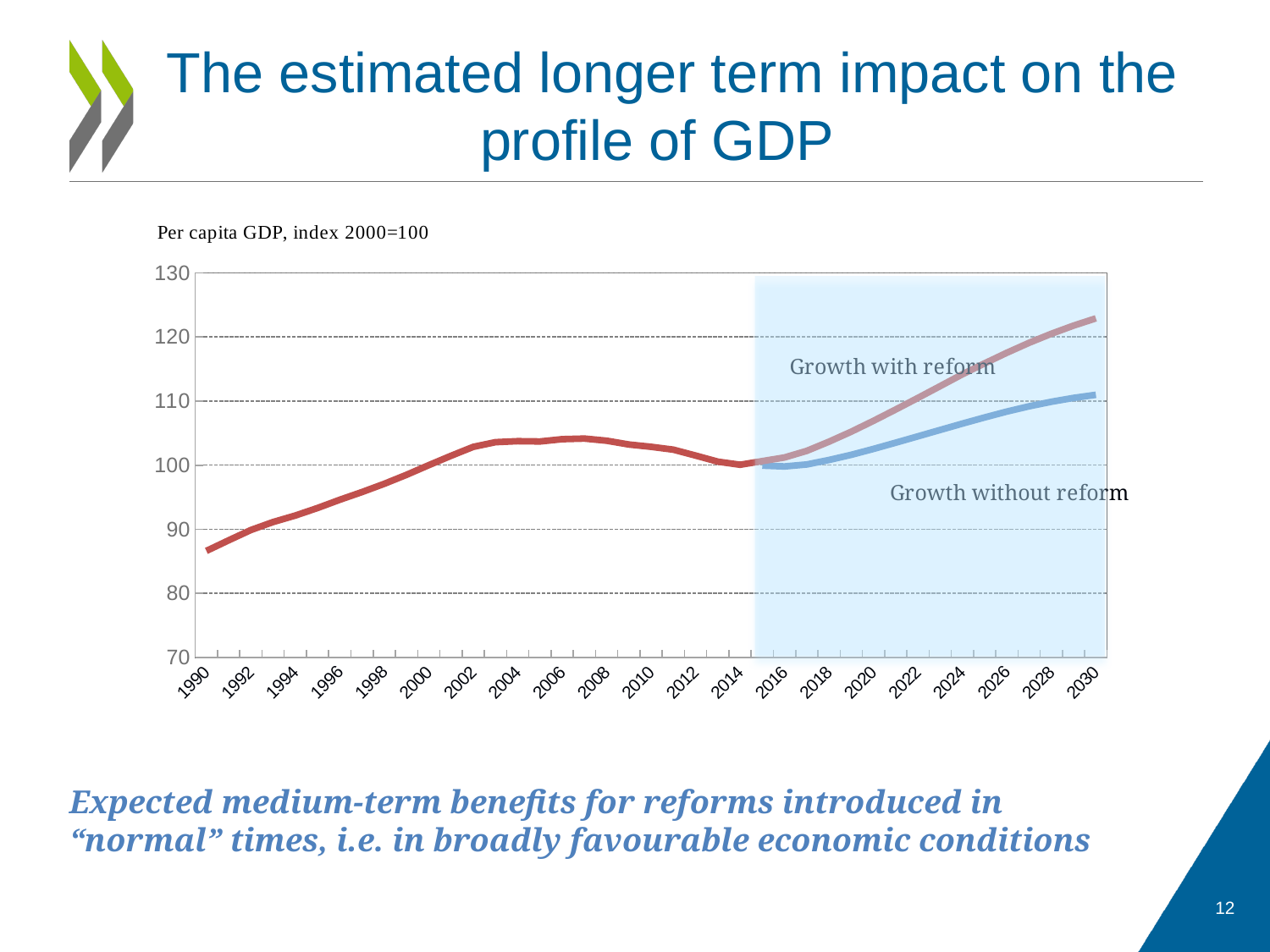
What is the title of the chart (the text above the plot area)? Per capita GDP, index 2000=100 In 2030, which line is higher: 'Growth with reform' or 'Growth without reform'? Growth with reform Does the per capita GDP index rise or fall between 1990 and 2002? rise What are the two labelled projection lines in the shaded area called? Growth with reform; Growth without reform Is the per capita GDP index value in 1990 greater or less than 90? less In which year does the chart show the lowest per capita GDP index value? 1990 What is the per capita GDP index value in 2000? 100 What kind of chart is shown on the slide? line chart How many labelled projection series are shown in the shaded area of the chart? 2 Is the 2030 value of the 'Growth without reform' line greater or less than 120? less Is the per capita GDP index value in 2006 greater or less than 100? greater